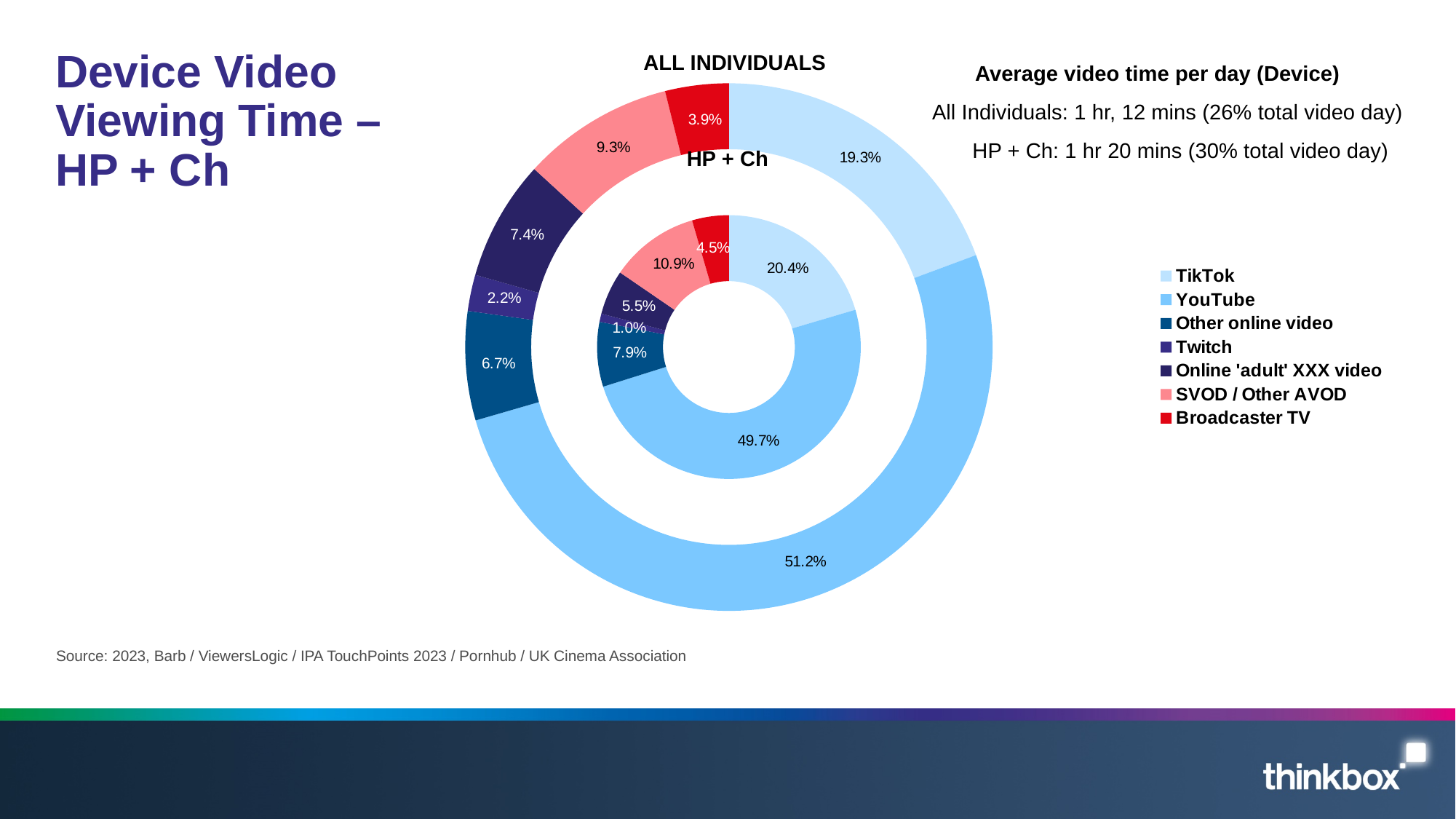
Which category has the largest share in the ALL INDIVIDUALS ring? YouTube In the ALL INDIVIDUALS ring, what share does SVOD / Other AVOD have? 9.3% What kind of chart is shown on the slide? Doughnut chart Which is larger: the Broadcaster TV share for ALL INDIVIDUALS or for HP + Ch? HP + Ch How many series does the legend list? 7 In the ALL INDIVIDUALS ring, what share does YouTube have? 51.2% What is the difference between the Online 'adult' XXX video share for ALL INDIVIDUALS and for HP + Ch? 1.9% In the HP + Ch ring, what share does TikTok have? 20.4% Which category has the smallest share in the HP + Ch ring? Twitch Which legend entry is shown in red? Broadcaster TV In the HP + Ch ring, what share does Twitch have? 1.0% What is the difference between the YouTube share for ALL INDIVIDUALS and for HP + Ch? 1.5%